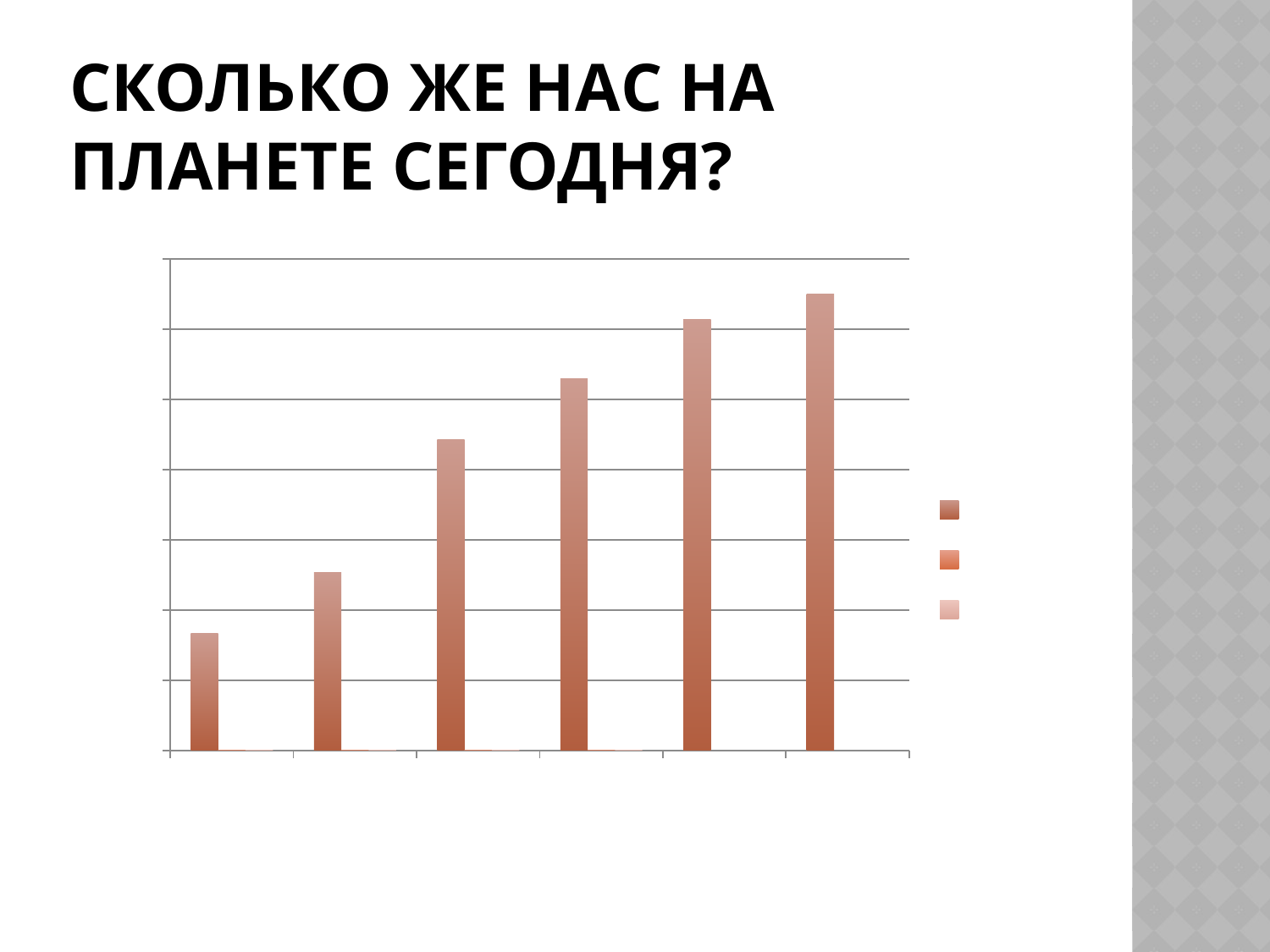
Which is shorter, the first bar or the sixth bar? the first bar Which bar is the tallest in the chart? the rightmost (sixth) bar Which bar is the shortest in the chart? the leftmost (first) bar What kind of chart is shown on the slide? bar chart How many bars are plotted in the chart? 6 Which is taller, the second bar from the left or the third bar from the left? the third bar How many entries does the legend show? 3 Do the bar values rise or fall from left to right along the x axis? rise What colour are the bars in the chart? orange-brown What is the title text at the top of the slide? СКОЛЬКО ЖЕ НАС НА ПЛАНЕТЕ СЕГОДНЯ? Which is taller, the fifth bar from the left or the fourth bar from the left? the fifth bar